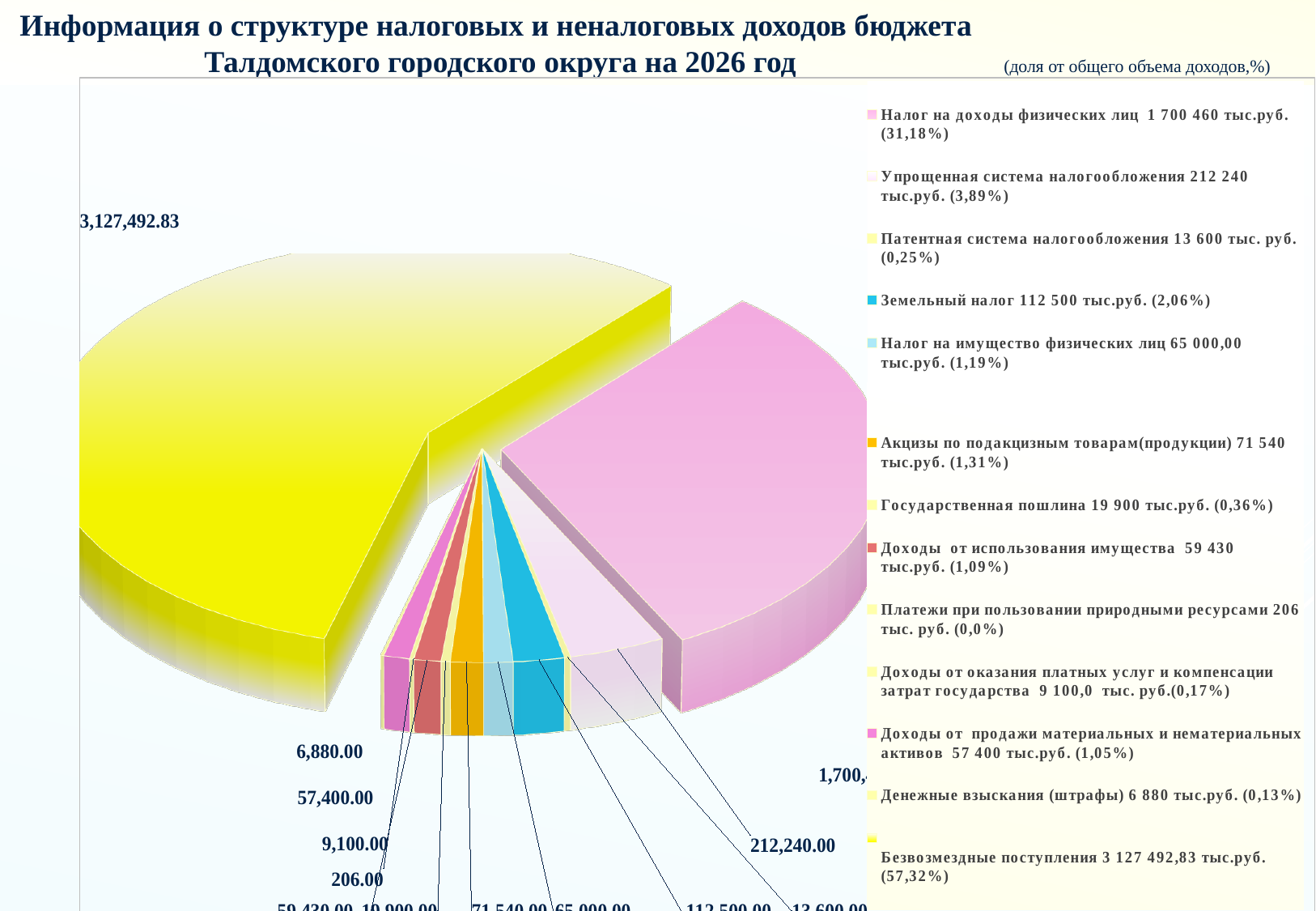
How many entries does the legend list? 13 Which is larger: Акцизы по подакцизным товарам or Доходы от использования имущества? Акцизы по подакцизным товарам What is the difference in percentage share between Безвозмездные поступления (57,32%) and Налог на доходы физических лиц (31,18%)? 26,14% What is the value shown for Упрощенная система налогообложения in the legend? 212 240 тыс.руб. What share of total revenue does Безвозмездные поступления account for, according to the legend? 57,32% What is the value shown for Земельный налог in the legend? 112 500 тыс.руб. What kind of chart is shown on the slide? pie chart Which category has the largest share of total revenue? Безвозмездные поступления What share of total revenue does Патентная система налогообложения account for, according to the legend? 0,25% What data label is shown on the chart for the Денежные взыскания (штрафы) slice? 6,880.00 What share of total revenue does Налог на доходы физических лиц account for, according to the legend? 31,18% Which category has the smallest share of total revenue? Платежи при пользовании природными ресурсами